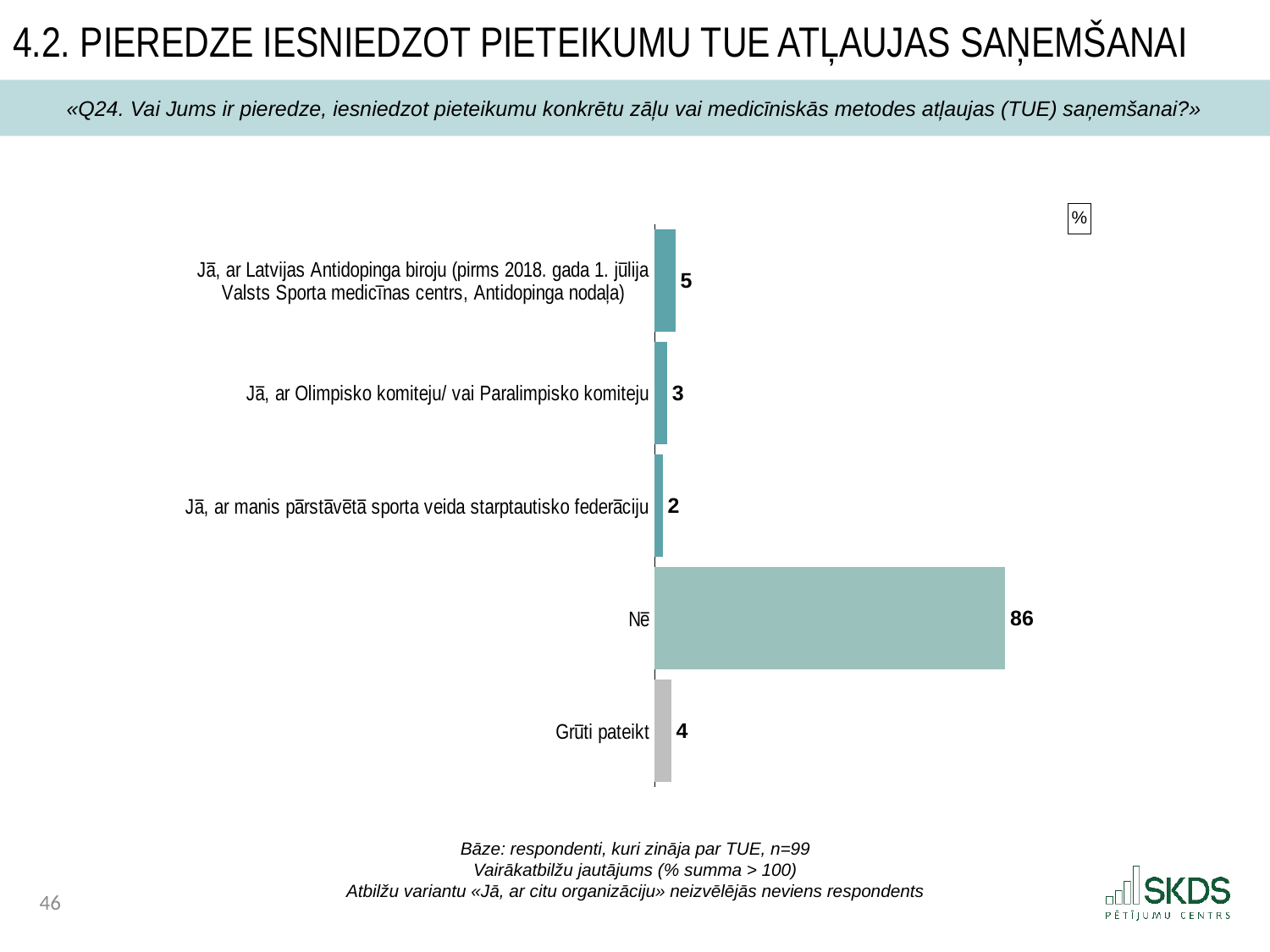
Which category has the lowest value? Jā, ar manis pārstāvētā sporta veida starptautisko federāciju Which is larger: the value for "Jā, ar Latvijas Antidopinga biroju" or the value for "Grūti pateikt"? Jā, ar Latvijas Antidopinga biroju What unit is indicated in the label at the top right of the chart? % Which category has the highest value? Nē How many categories are shown in the chart? 5 What is the value for "Jā, ar Olimpisko komiteju/ vai Paralimpisko komiteju"? 3 What is the value for "Nē"? 86 What is the difference between the value for "Jā, ar Latvijas Antidopinga biroju" and the value for "Jā, ar Olimpisko komiteju/ vai Paralimpisko komiteju"? 2 What kind of chart is shown on the slide? Bar chart What is the difference between the value for "Nē" and the value for "Grūti pateikt"? 82 What is the value for "Jā, ar manis pārstāvētā sporta veida starptautisko federāciju"? 2 What is the value for "Grūti pateikt"? 4